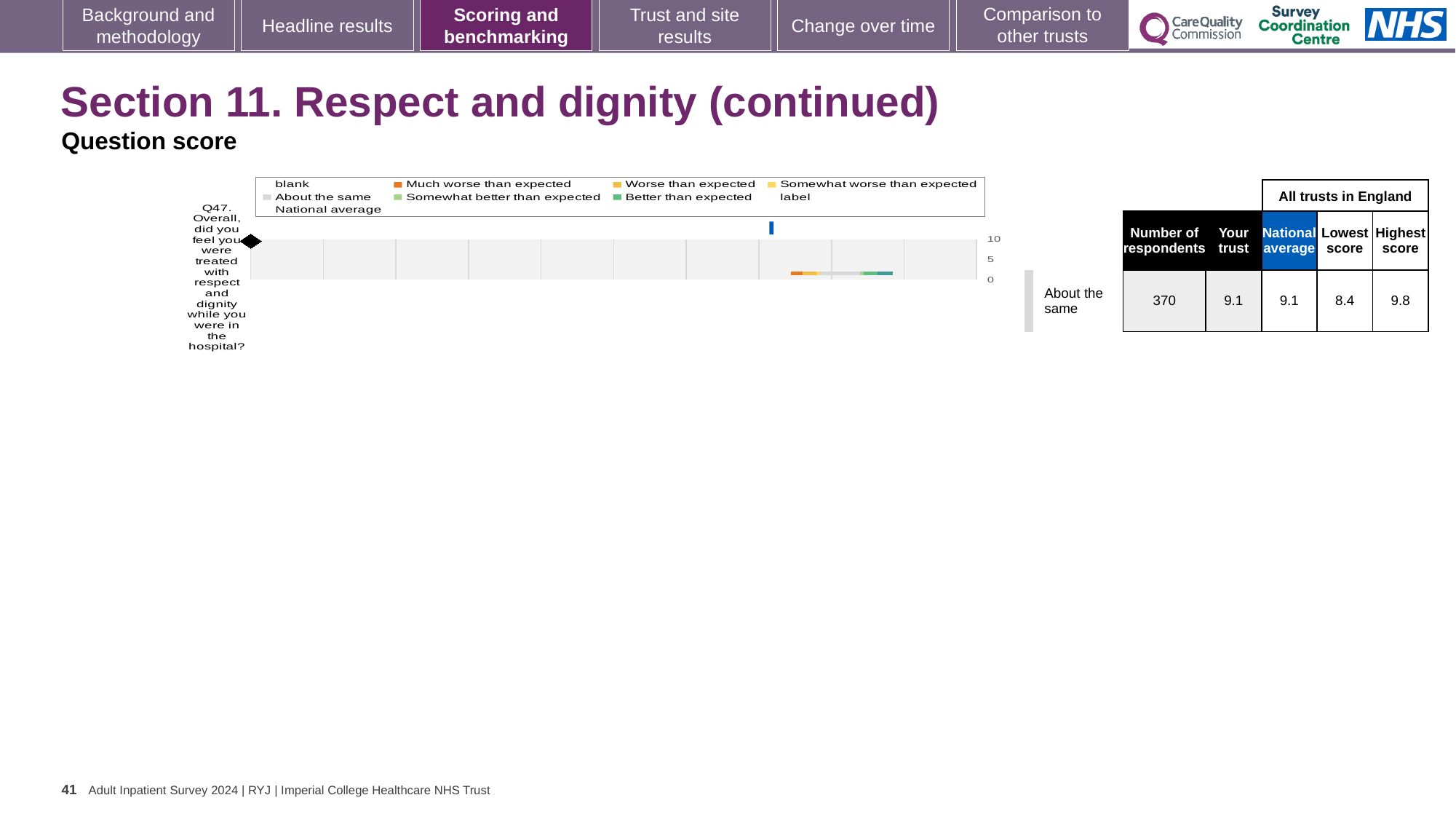
According to the table beside the chart, how many respondents answered Q47? 370 How many questions (categories) are plotted on the chart? 1 What is the difference between the Highest score and the Lowest score for Q47 in the table beside the chart? 1.4 According to the table beside the chart, what is the National average score for Q47? 9.1 Which benchmark category label is shown next to the chart for Q47? About the same What is the highest tick value shown on the chart's score axis? 10 What kind of chart is shown on the slide? bar chart According to the table beside the chart, what is the Lowest score among all trusts in England for Q47? 8.4 Is the Lowest score for Q47 in the table beside the chart greater or less than 5? greater How many entries does the chart legend list? 9 According to the table beside the chart, what is the 'Your trust' score for Q47? 9.1 According to the table beside the chart, what is the Highest score among all trusts in England for Q47? 9.8